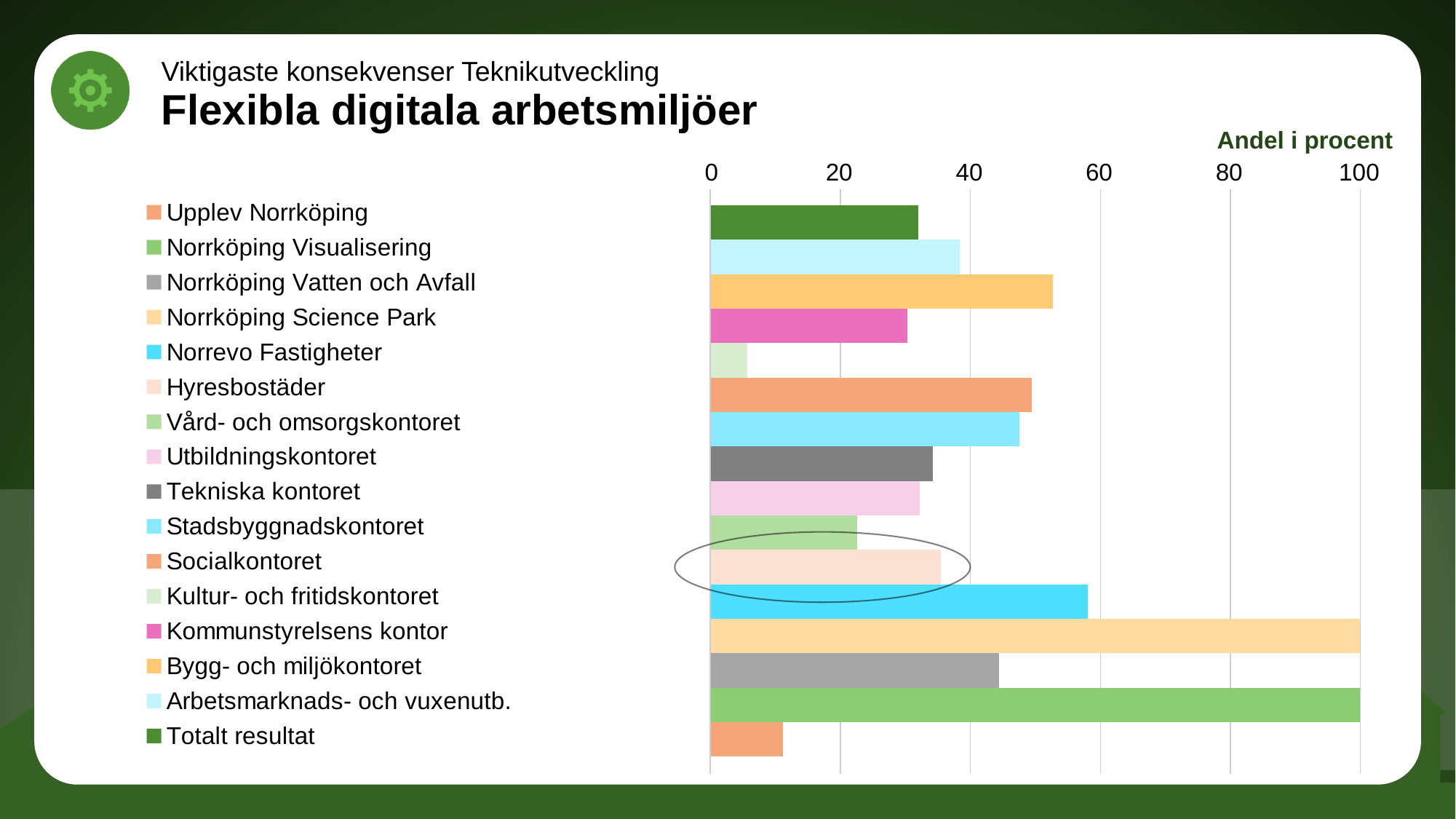
Which is larger, the value for Socialkontoret or the value for Kommunstyrelsens kontor? Socialkontoret Is the value for Totalt resultat greater or less than 40? less Which two legend entries reach 100 on the axis? Norrköping Science Park and Norrköping Visualisering What kind of chart is shown on the slide? bar chart Is the value for Bygg- och miljökontoret greater or less than 40? greater Which legend entry has the lowest value? Kultur- och fritidskontoret How many entries does the legend list? 16 What value does the bar for Norrköping Visualisering reach? 100 What is the title of the horizontal axis? Andel i procent Is the value for Norrevo Fastigheter greater or less than 40? greater Which legend entry's bar is circled on the chart? Hyresbostäder